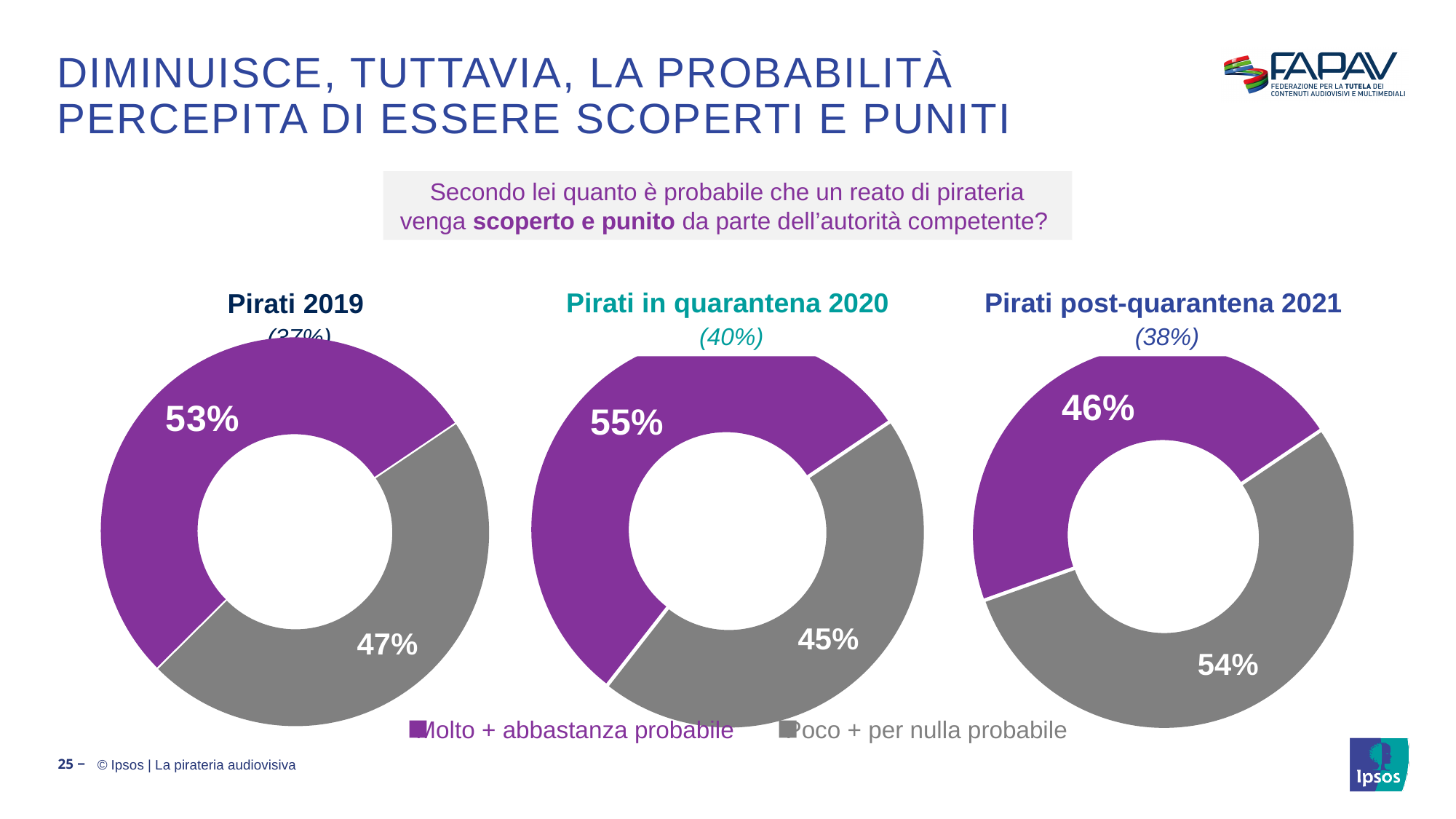
In the 'Pirati 2019' chart, what share is 'Molto + abbastanza probabile'? 53% In the 'Pirati 2019' chart, which slice is larger, 'Molto + abbastanza probabile' or 'Poco + per nulla probabile'? Molto + abbastanza probabile Across the three charts, which group has the highest share for 'Molto + abbastanza probabile'? Pirati in quarantena 2020 In the 'Pirati post-quarantena 2021' chart, what share is 'Molto + abbastanza probabile'? 46% In the 'Pirati post-quarantena 2021' chart, which slice is larger, 'Molto + abbastanza probabile' or 'Poco + per nulla probabile'? Poco + per nulla probabile How many entries does the legend list? 2 In the 'Pirati in quarantena 2020' chart, what share is 'Poco + per nulla probabile'? 45% What kind of chart is used on this slide? Donut (pie) chart What is the difference between the 'Molto + abbastanza probabile' share in the 'Pirati in quarantena 2020' chart and in the 'Pirati post-quarantena 2021' chart? 9 percentage points In the 'Pirati post-quarantena 2021' chart, what share is 'Poco + per nulla probabile'? 54% In the 'Pirati in quarantena 2020' chart, what is the difference between the two slices? 10 percentage points Across the three charts, which group has the lowest share for 'Molto + abbastanza probabile'? Pirati post-quarantena 2021